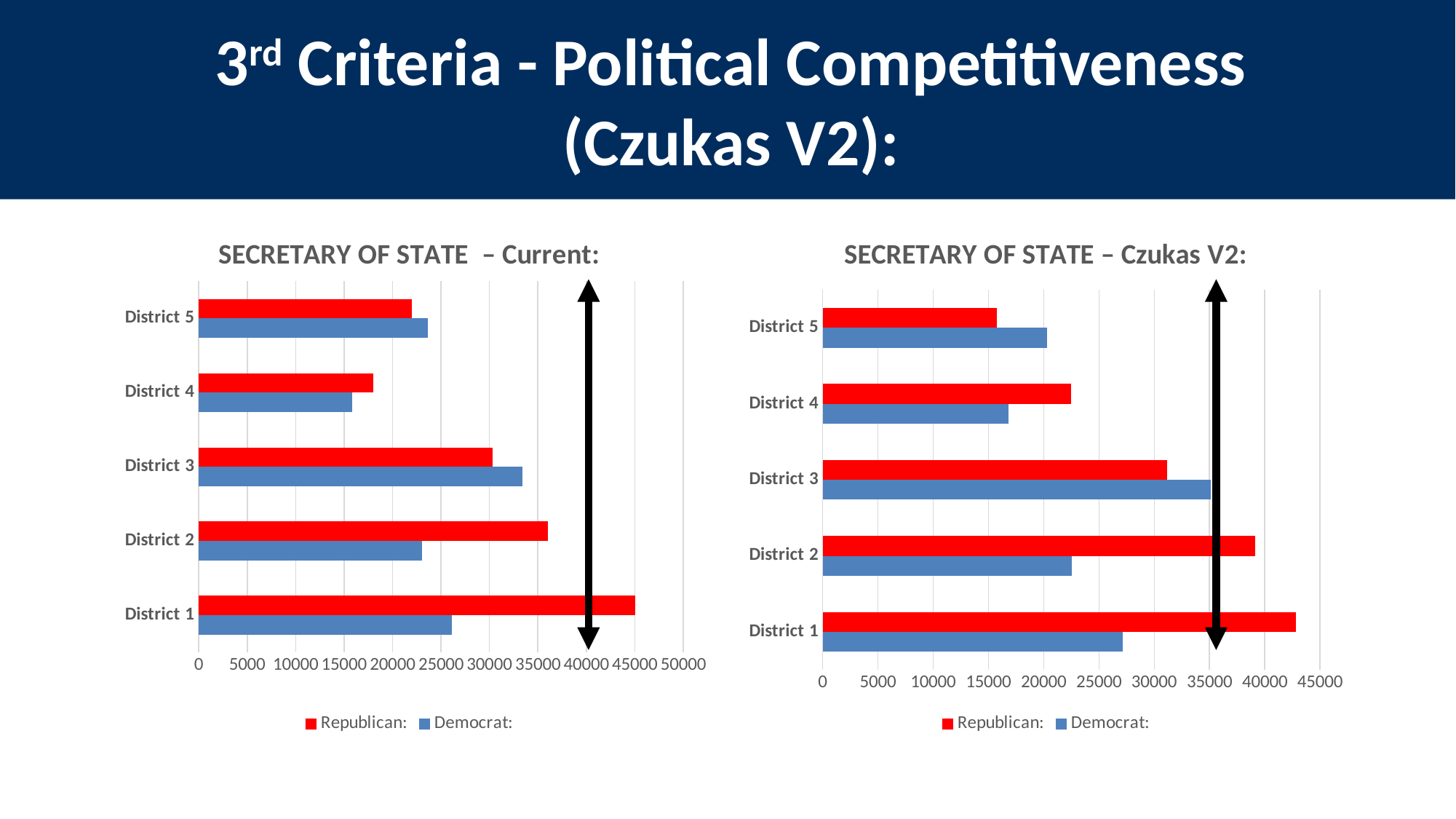
In the "SECRETARY OF STATE – Current:" chart, is the Republican value for District 1 greater or less than 40000? greater What kind of chart is the "SECRETARY OF STATE – Current:" chart on the left? bar chart In the "SECRETARY OF STATE – Current:" chart, how many series does the legend list? 2 In the "SECRETARY OF STATE – Current:" chart, how many districts are shown on the y axis? 5 In the "SECRETARY OF STATE – Current:" chart, is the Democrat value for District 4 greater or less than 20000? less In the "SECRETARY OF STATE – Current:" chart, for District 2, which is larger: the Republican or the Democrat value? Republican In the "SECRETARY OF STATE – Czukas V2:" chart, which district has the lowest Republican value? District 5 In the "SECRETARY OF STATE – Czukas V2:" chart, is the Republican value for District 2 greater or less than 35000? greater In the "SECRETARY OF STATE – Czukas V2:" chart, which colour represents the Democrat series? blue In the "SECRETARY OF STATE – Czukas V2:" chart, for District 3, which is larger: the Republican or the Democrat value? Democrat In the "SECRETARY OF STATE – Czukas V2:" chart, which district has the highest Democrat value? District 3 In the "SECRETARY OF STATE – Current:" chart, which district has the highest Republican value? District 1